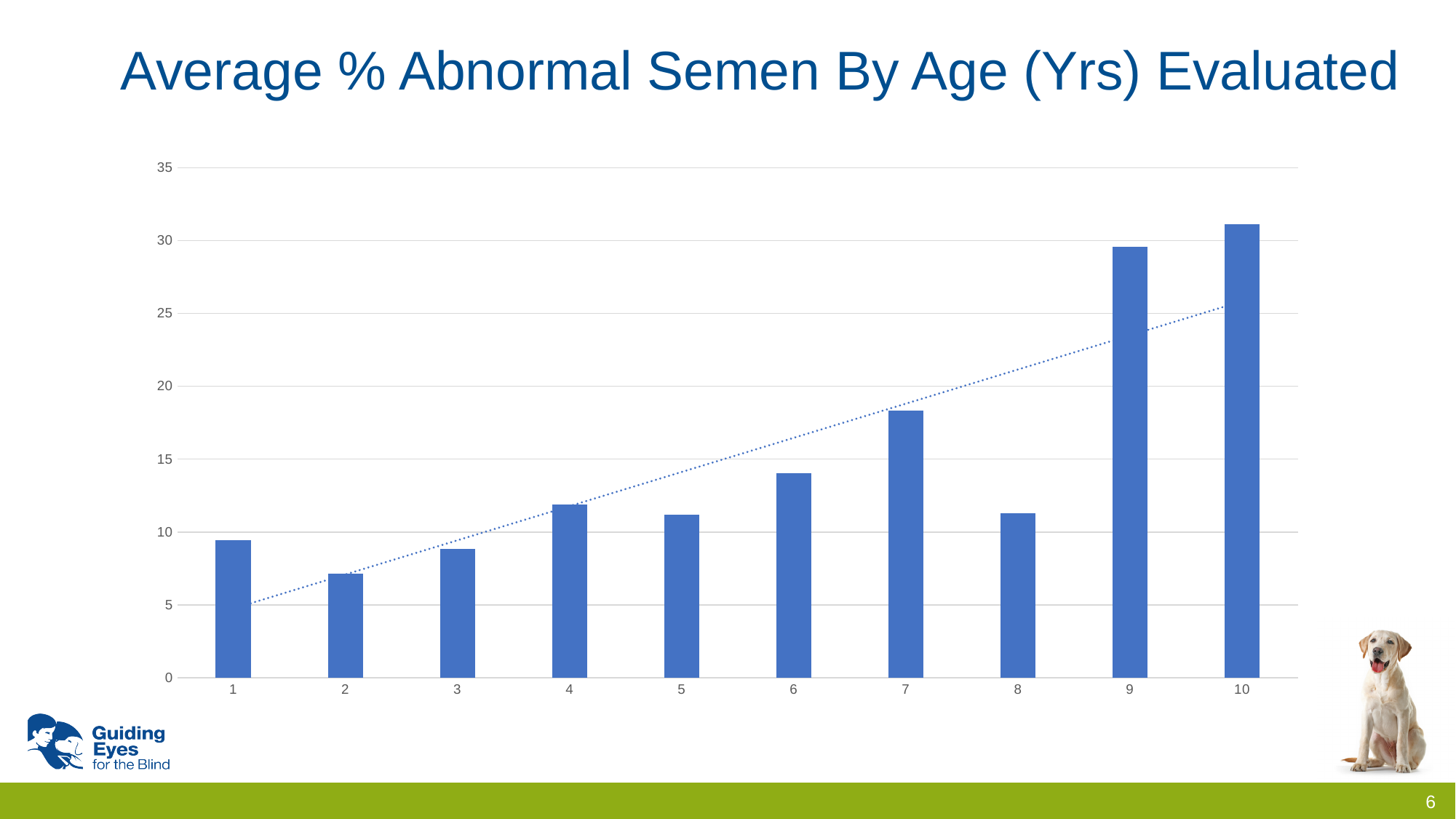
Is the value for age 7 greater or less than 15? greater Which is larger, the value for age 7 or the value for age 8? age 7 Which age has the highest average % abnormal semen? 10 Is the value for age 9 greater or less than 25? greater How many age categories are plotted on the x axis? 10 What kind of chart is shown on the slide? bar chart Is the value for age 10 greater or less than 30? greater What is the title of the chart? Average % Abnormal Semen By Age (Yrs) Evaluated Do the values generally rise or fall as age increases from 1 to 10? rise Which age has the lowest average % abnormal semen? 2 What style of line is drawn across the bars to show the trend? dotted line